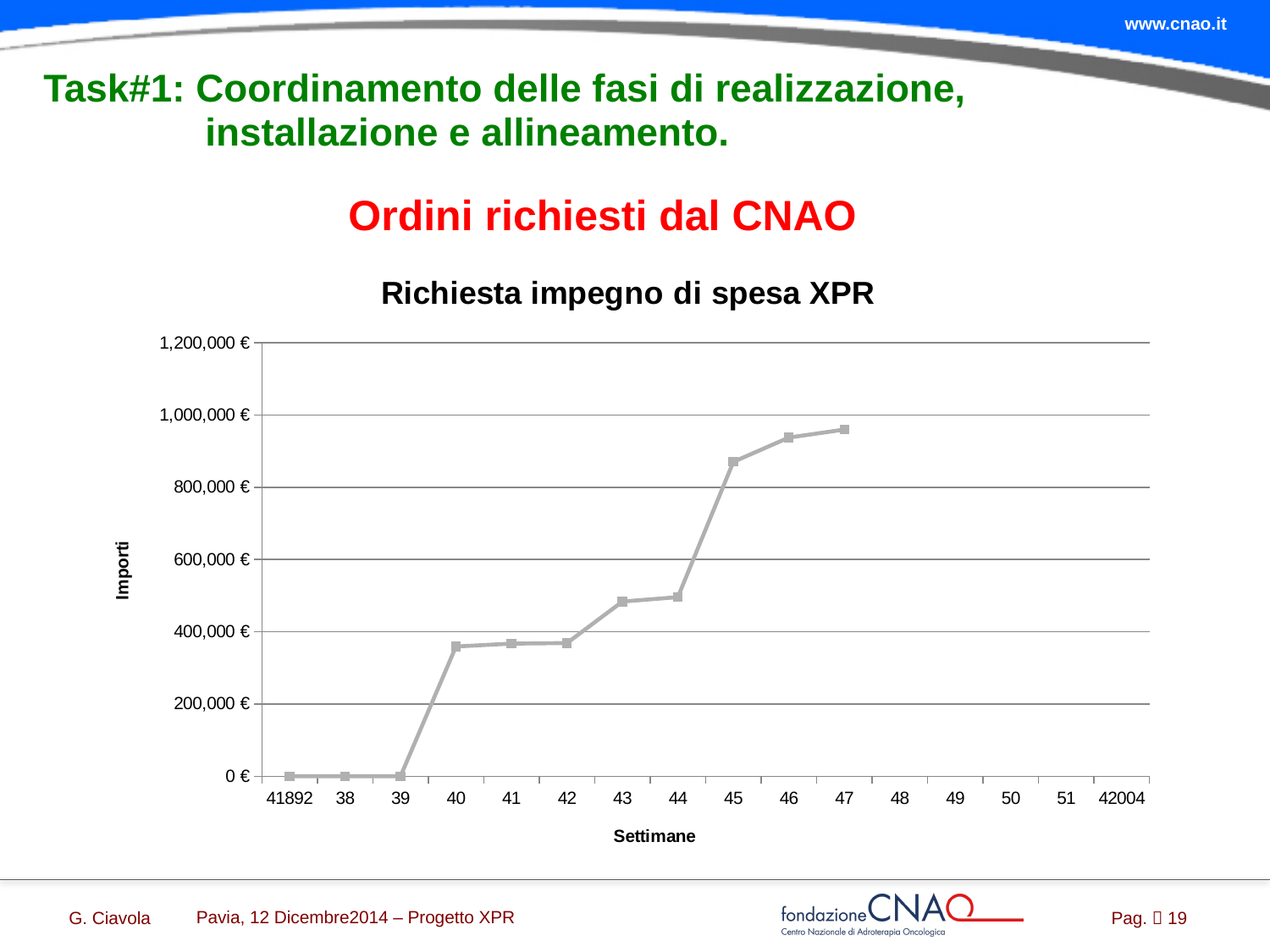
What kind of chart is shown on the slide? line chart How many data points are plotted on the line? 11 Which week has the highest plotted value? 47 Which is larger, the value for week 44 or the value for week 45? week 45 Is the value for week 47 greater or less than 1,000,000 €? less What is the title of the chart? Richiesta impegno di spesa XPR Is the value for week 40 greater or less than 400,000 €? less Is the value for week 45 greater or less than 800,000 €? greater Do the plotted values generally rise or fall from left to right along the x axis? rise What is the label of the y axis? Importi